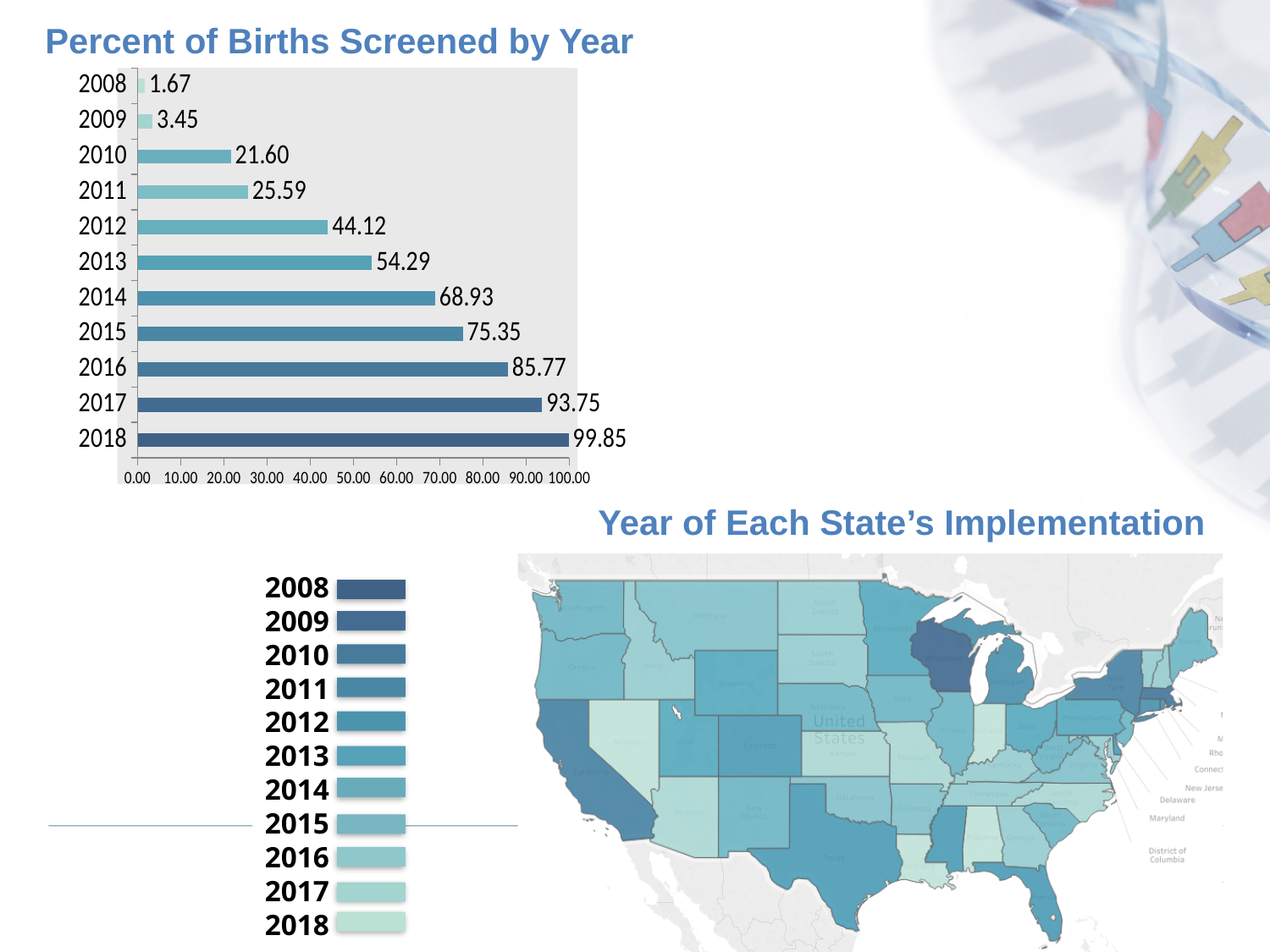
In the 'Percent of Births Screened by Year' chart, do the values rise or fall from 2008 to 2018? Rise In the 'Percent of Births Screened by Year' chart, what is the value for 2017? 93.75 In the 'Percent of Births Screened by Year' chart, is the value for 2015 greater or less than 70.00? greater In the 'Percent of Births Screened by Year' chart, which year has the lowest value? 2008 In the 'Percent of Births Screened by Year' chart, which is larger, the value for 2012 or the value for 2013? 2013 In the 'Percent of Births Screened by Year' chart, which year has the highest value? 2018 What kind of chart is 'Percent of Births Screened by Year'? Bar chart In the 'Percent of Births Screened by Year' chart, what is the difference between the values for 2014 and 2013? 14.64 How many years are shown in the 'Percent of Births Screened by Year' chart? 11 In the 'Percent of Births Screened by Year' chart, what is the value for 2010? 21.60 In the 'Percent of Births Screened by Year' chart, what is the value for 2014? 68.93 In the 'Percent of Births Screened by Year' chart, what is the difference between the values for 2018 and 2017? 6.10